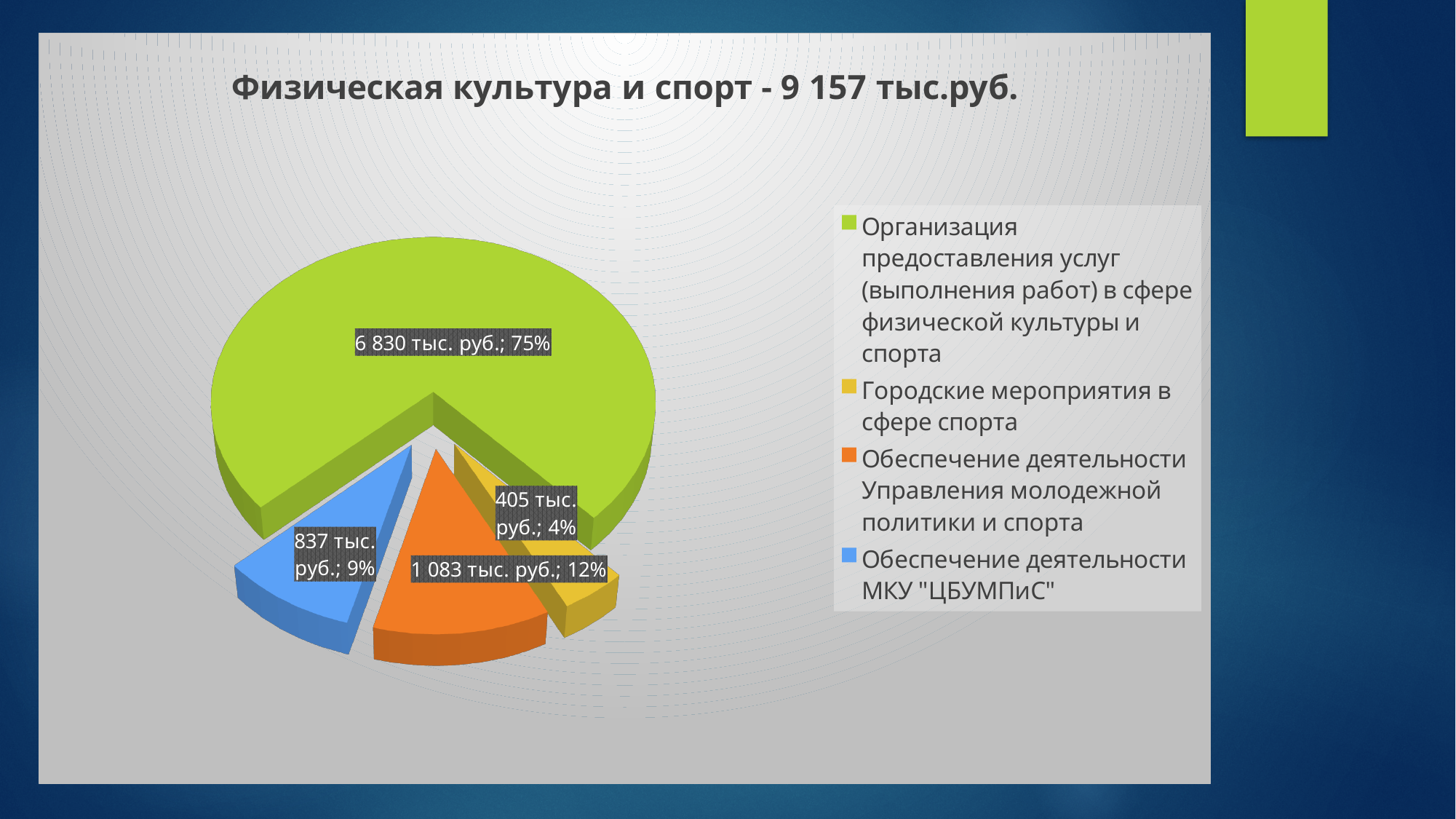
Which is larger: "Обеспечение деятельности Управления молодежной политики и спорта" or "Обеспечение деятельности МКУ "ЦБУМПиС""? Обеспечение деятельности Управления молодежной политики и спорта How many entries does the legend list? 4 Which category has the smallest slice? Городские мероприятия в сфере спорта What share of the pie does "Обеспечение деятельности МКУ "ЦБУМПиС"" represent? 9% Which category has the largest slice? Организация предоставления услуг (выполнения работ) в сфере физической культуры и спорта What is the title of the chart? Физическая культура и спорт - 9 157 тыс.руб. What kind of chart is shown on the slide? Pie chart How many slices does the pie chart have? 4 What is the difference between the values for "Обеспечение деятельности Управления молодежной политики и спорта" and "Городские мероприятия в сфере спорта"? 678 тыс. руб. What is the value for "Городские мероприятия в сфере спорта"? 405 тыс. руб. What is the value for "Обеспечение деятельности Управления молодежной политики и спорта"? 1 083 тыс. руб. What is the value for "Организация предоставления услуг (выполнения работ) в сфере физической культуры и спорта"? 6 830 тыс. руб.